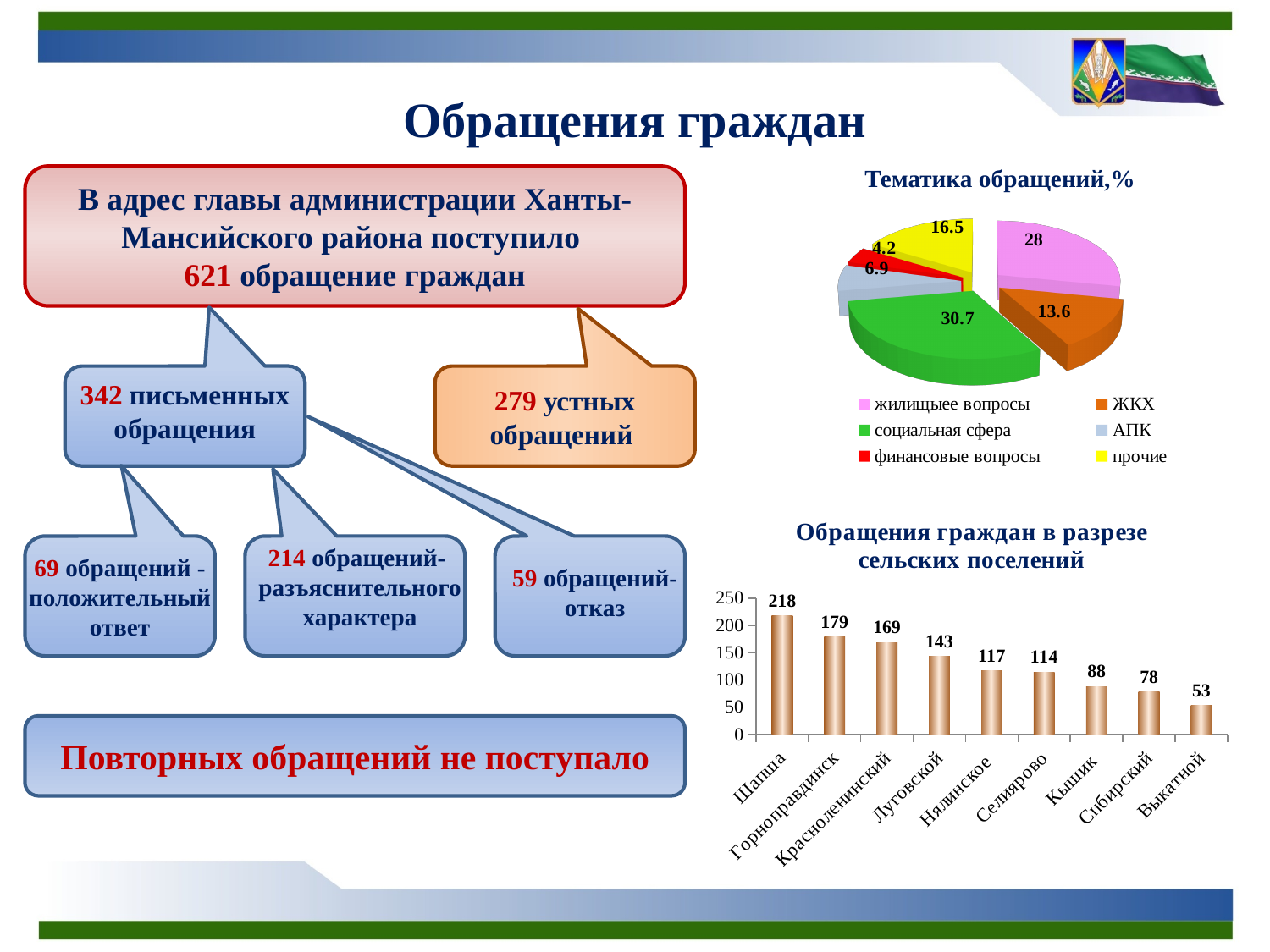
In the pie chart 'Тематика обращений,%', which is larger: ЖКХ or прочие? прочие In the bar chart 'Обращения граждан в разрезе сельских поселений', do the values rise or fall from left to right? fall In the bar chart 'Обращения граждан в разрезе сельских поселений', which settlement has the lowest value? Выкатной In the bar chart 'Обращения граждан в разрезе сельских поселений', what is the value for Луговской? 143 In the bar chart 'Обращения граждан в разрезе сельских поселений', what is the difference between Горноправдинск and Красноленинский? 10 What type of chart is 'Обращения граждан в разрезе сельских поселений'? bar chart In the pie chart 'Тематика обращений,%', what is the share for социальная сфера? 30.7 In the bar chart 'Обращения граждан в разрезе сельских поселений', how many settlements are shown? 9 In the pie chart 'Тематика обращений,%', which category has the largest share? социальная сфера In the bar chart 'Обращения граждан в разрезе сельских поселений', what is the value for Шапша? 218 In the bar chart 'Обращения граждан в разрезе сельских поселений', which settlement has the highest value? Шапша In the pie chart 'Тематика обращений,%', what is the share for финансовые вопросы? 4.2